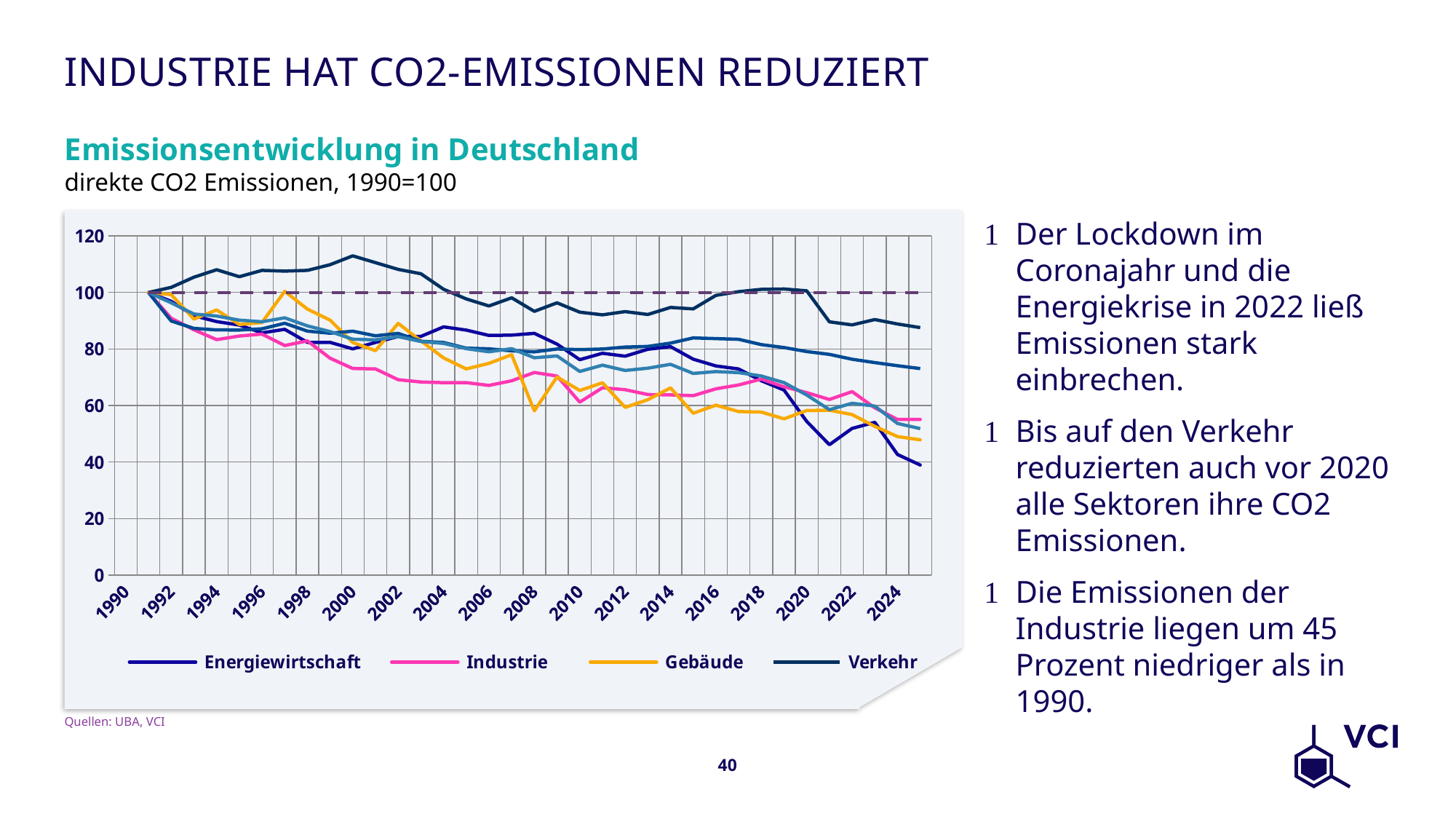
Which is larger in 2010, the value for Verkehr or the value for Industrie? Verkehr Which series has the highest value in 2024? Verkehr What is the index value of all series in 1990? 100 How many series does the chart legend list? 4 Is the value for Verkehr in 2000 greater or less than 100? greater Is the value for Verkehr in 2024 greater or less than 80? greater What is the title of the chart? Emissionsentwicklung in Deutschland Which series has the lowest value in 2024? Energiewirtschaft What kind of chart is shown on the slide? line chart Is the value for Gebäude in 2024 greater or less than 60? less Does the Industrie series rise or fall from 1990 to 2024? fall